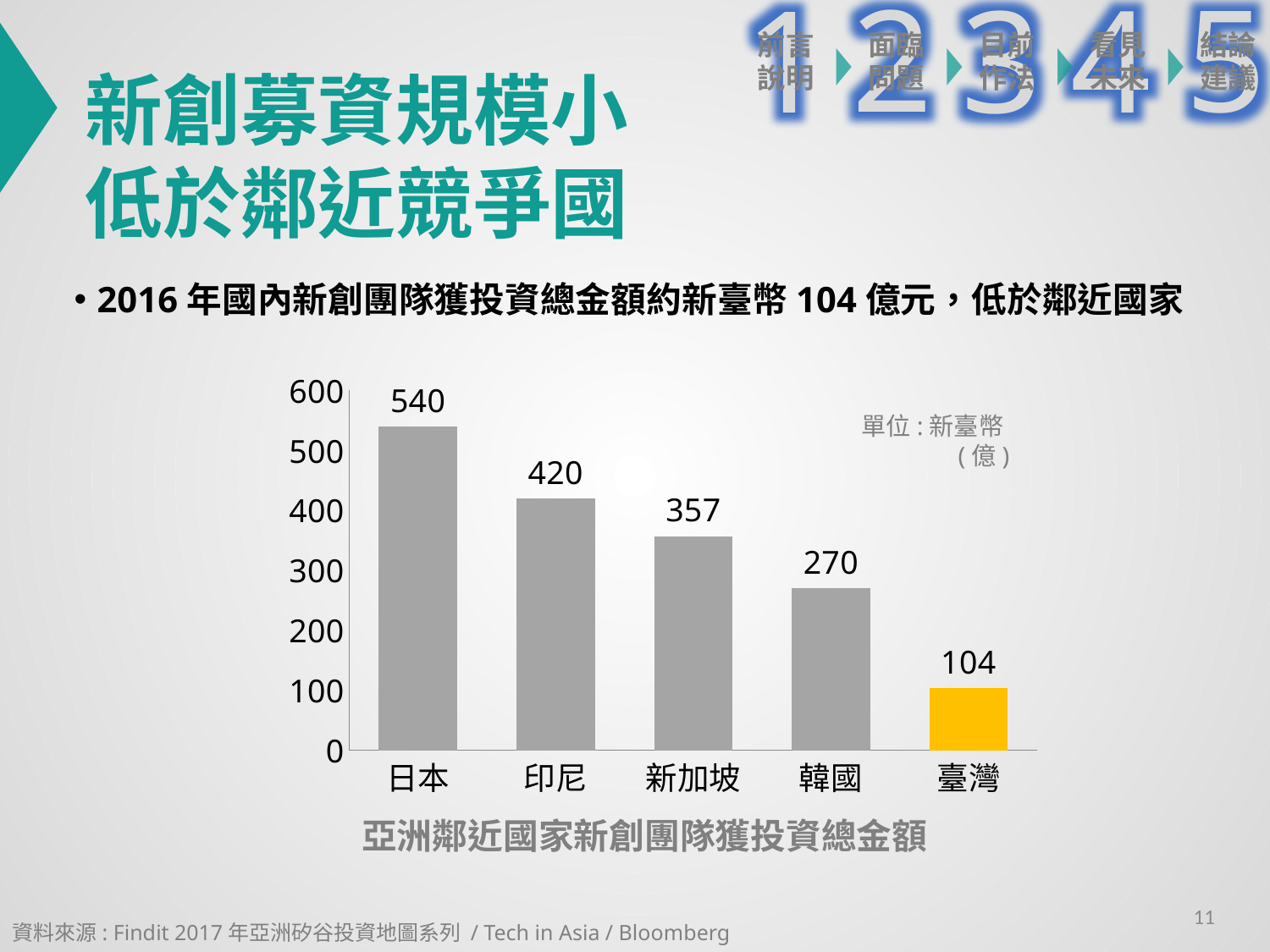
What is the value for 臺灣? 104 What is the value for 新加坡? 357 Which is larger, the value for 新加坡 or the value for 韓國? 新加坡 What is the value for 日本? 540 Which category has the lowest value? 臺灣 Is the value for 韓國 greater or less than 300? less How many categories are shown in the chart? 5 Which bar is coloured differently (yellow) from the others? 臺灣 What kind of chart is shown on the slide? bar chart Which category has the highest value? 日本 What is the difference between the values for 日本 and 臺灣? 436 What is the difference between the values for 印尼 and 韓國? 150